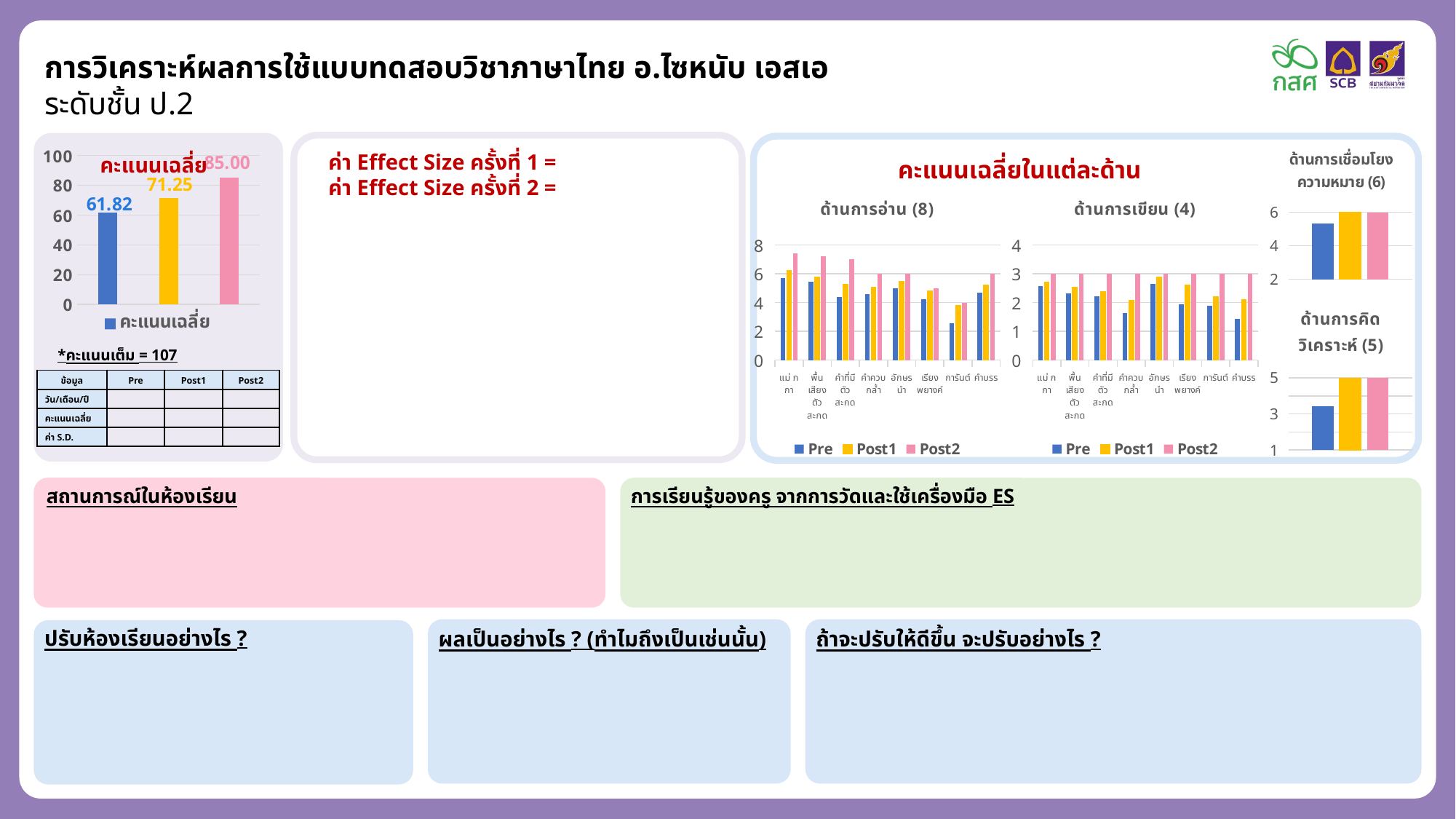
In the "คะแนนเฉลี่ย" chart on the left, which bar is the highest? The third (pink) bar, 85.00 In the "คะแนนเฉลี่ย" chart on the left, what is the value of the middle (yellow) bar? 71.25 What type of chart is the "คะแนนเฉลี่ย" chart on the left? Bar chart In the "ด้านการอ่าน (8)" chart, is the Post2 value for the first category (แม่ กก) greater or less than 6? greater In the "ด้านการเขียน (4)" chart, how many categories are shown on the x axis? 8 In the "คะแนนเฉลี่ย" chart on the left, what is the value of the first (blue) bar? 61.82 In the "ด้านการคิดวิเคราะห์ (5)" chart, which is larger, the Pre bar or the Post1 bar? Post1 In the "คะแนนเฉลี่ย" chart on the left, how many bars are plotted? 3 In the "ด้านการเขียน (4)" chart, is the Pre value for the last category (คำบรร) greater or less than 2? less In the "คะแนนเฉลี่ย" chart on the left, what is the value of the third (pink) bar? 85.00 In the "ด้านการอ่าน (8)" chart, how many series does the legend list? 3 In the "คะแนนเฉลี่ย" chart on the left, what is the difference between the pink bar and the blue bar? 23.18